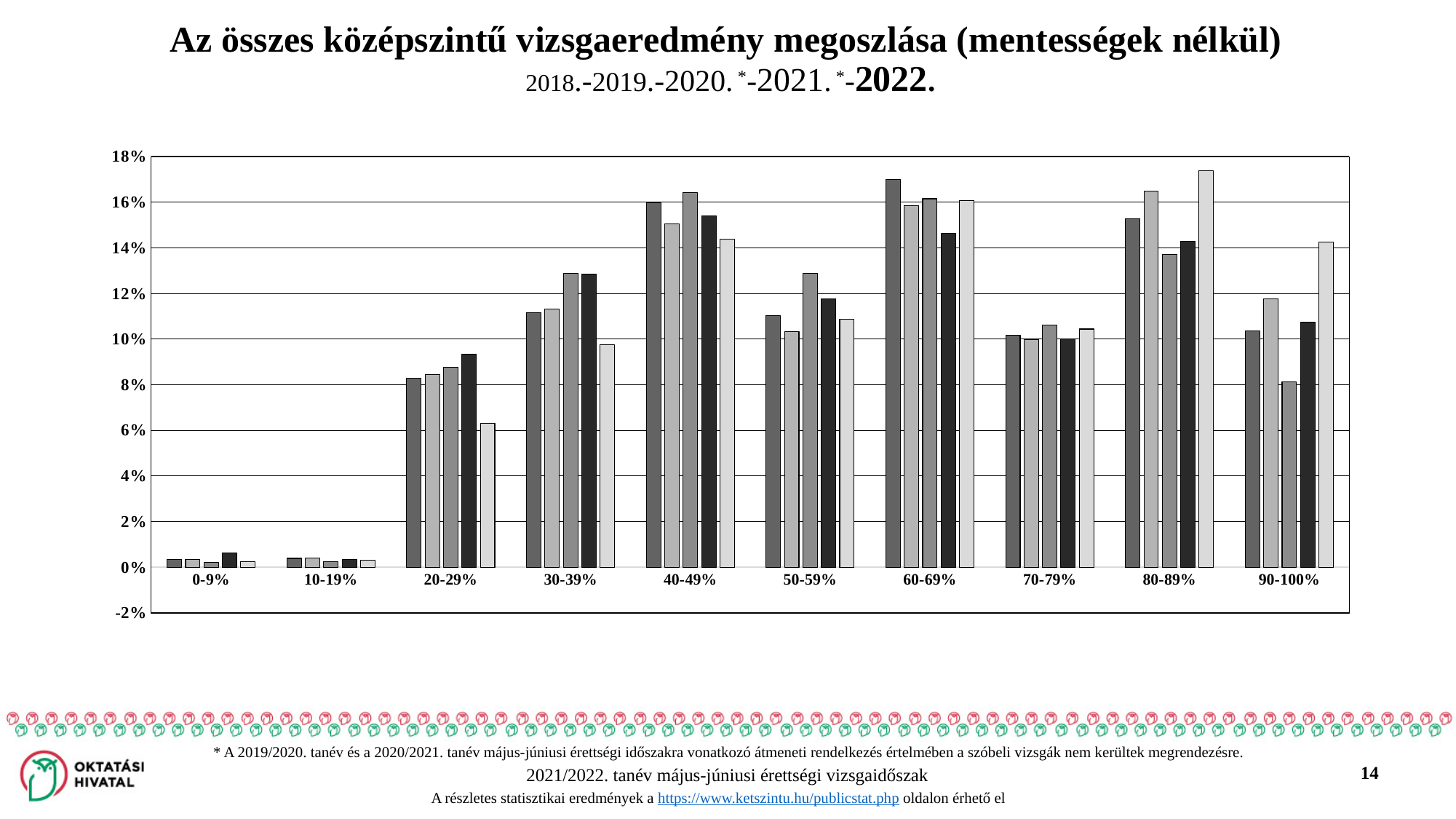
What is the highest value shown on the y axis? 18% Is the value of the rightmost bar in the 20-29% group greater or less than 8%? less Is the value of the rightmost bar in the 80-89% group greater or less than 16%? greater In the 90-100% group, which is taller: the third bar or the fourth bar from the left? the fourth bar How many bars are plotted for each score-range category? 5 Is the value of the leftmost bar in the 60-69% group greater or less than 16%? greater What kind of chart is shown on the slide? bar chart Which is taller: the leftmost bar in the 40-49% group or the leftmost bar in the 50-59% group? 40-49% How many score-range categories are shown on the x axis? 10